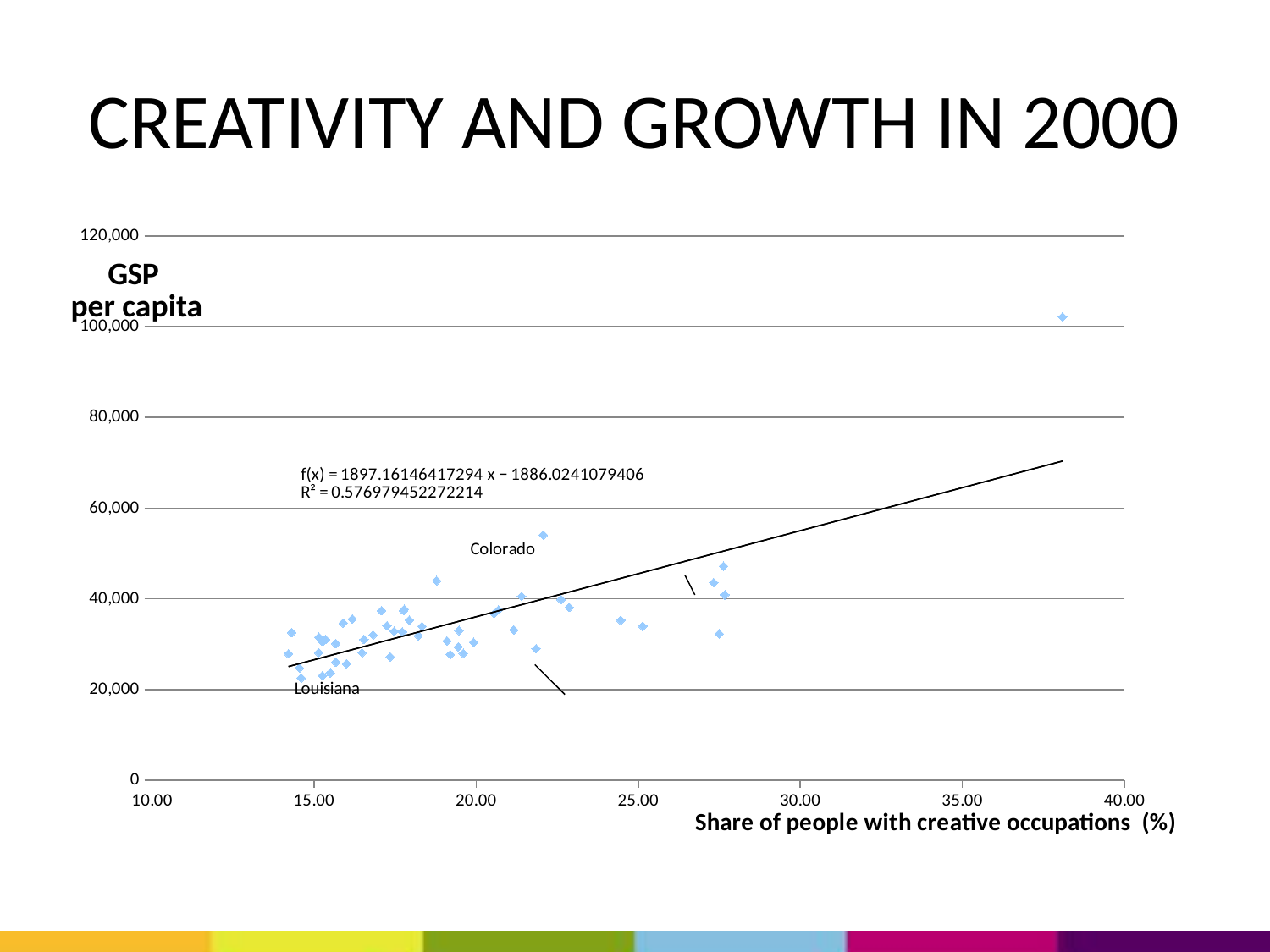
Is the GSP per capita of the point labelled Colorado greater or less than 40,000? greater What is the slope printed in the trendline equation f(x)? 1897.16146417294 Is the GSP per capita of the point labelled Louisiana greater or less than 40,000? less Is the GSP per capita of the highest point on the chart (at about 38% creative share) greater or less than 80,000? greater What kind of chart is shown on the slide? scatter chart What is the highest value shown on the vertical axis? 120,000 What R² value is printed on the chart? 0.576979452272214 What is the highest value shown on the horizontal axis? 40.00 According to the trendline, do GSP per capita values rise or fall as the share of people with creative occupations increases? rise What is the title of the slide's chart? CREATIVITY AND GROWTH IN 2000 What is the label of the horizontal axis? Share of people with creative occupations (%) Which labelled state, Colorado or Louisiana, has the higher GSP per capita? Colorado